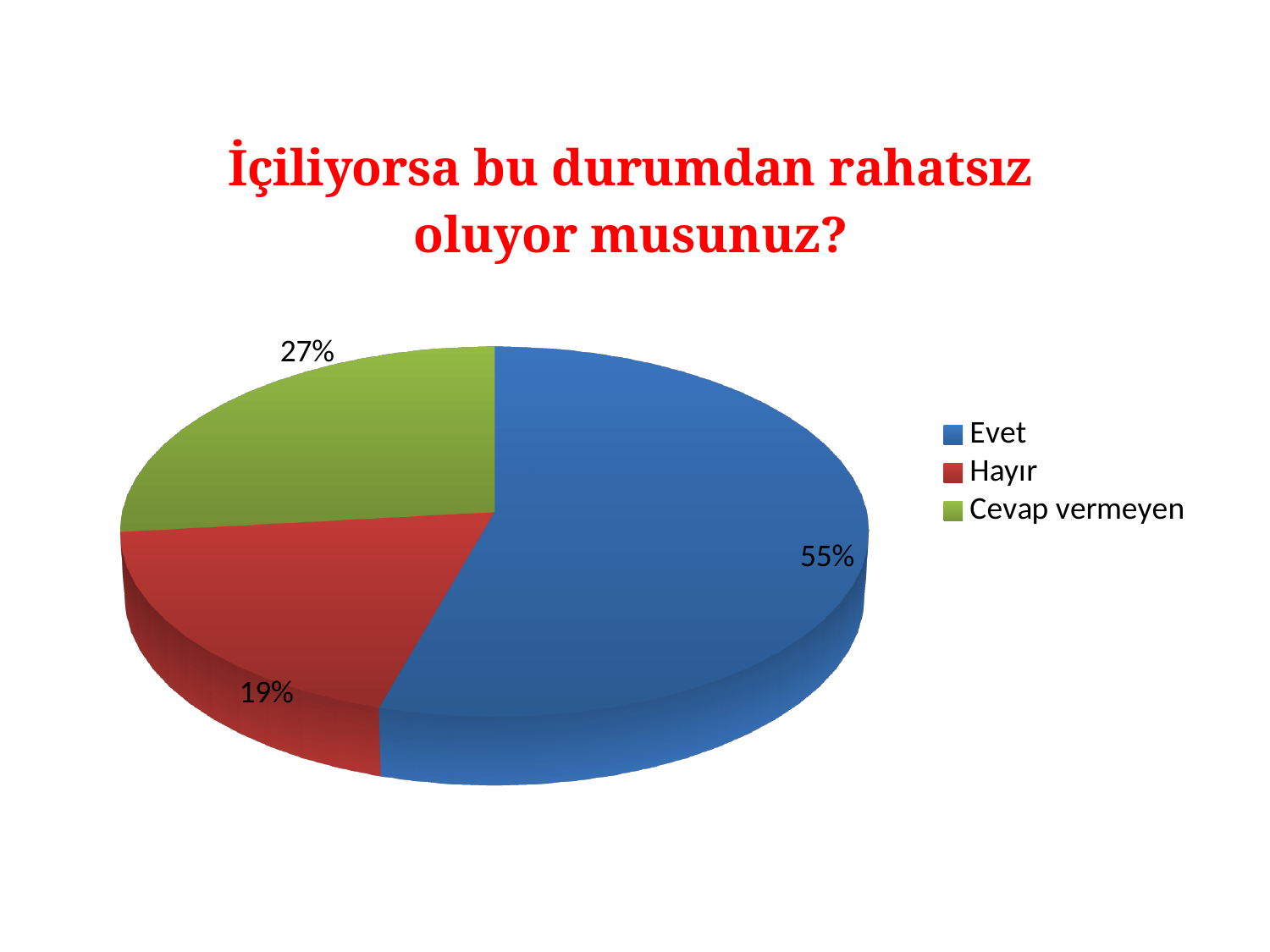
What share of the pie does Hayır represent? 19% How many categories does the pie chart show? 3 What is the difference in percentage points between Cevap vermeyen and Hayır? 8 What is the title of the chart? İçiliyorsa bu durumdan rahatsız oluyor musunuz? Which category has the smallest slice of the pie? Hayır Which colour represents Hayır in the legend? Red What share of the pie does Cevap vermeyen represent? 27% What kind of chart is shown on the slide? Pie chart Which category has the largest slice of the pie? Evet What is the difference in percentage points between Evet and Hayır? 36 What share of the pie does Evet represent? 55% Which is larger, the share for Hayır or the share for Cevap vermeyen? Cevap vermeyen